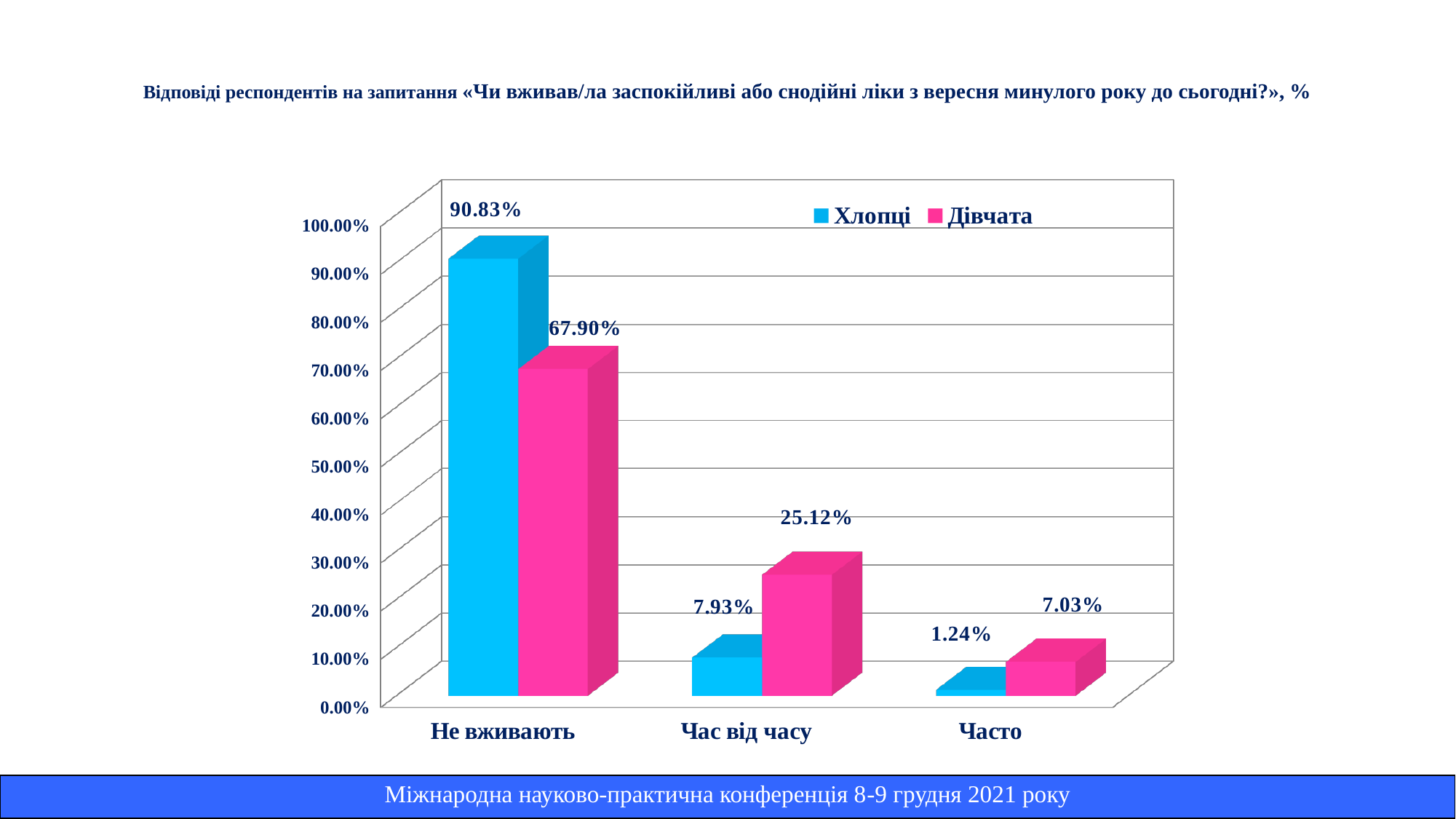
Which colour represents the series Дівчата in the chart? Pink What value is shown for Хлопці in the category Не вживають? 90.83% What is the difference between the Хлопці and Дівчата values in the category Не вживають? 22.93% How many categories are shown on the x axis? 3 In the category Час від часу, which series has the larger value, Хлопці or Дівчата? Дівчата What value is shown for Хлопці in the category Часто? 1.24% Which category has the highest value for Дівчата? Не вживають What value is shown for Дівчата in the category Час від часу? 25.12% What kind of chart is shown on the slide? Bar chart How many series does the legend list? 2 What value is shown for Дівчата in the category Часто? 7.03% Which category has the lowest value for Хлопці? Часто